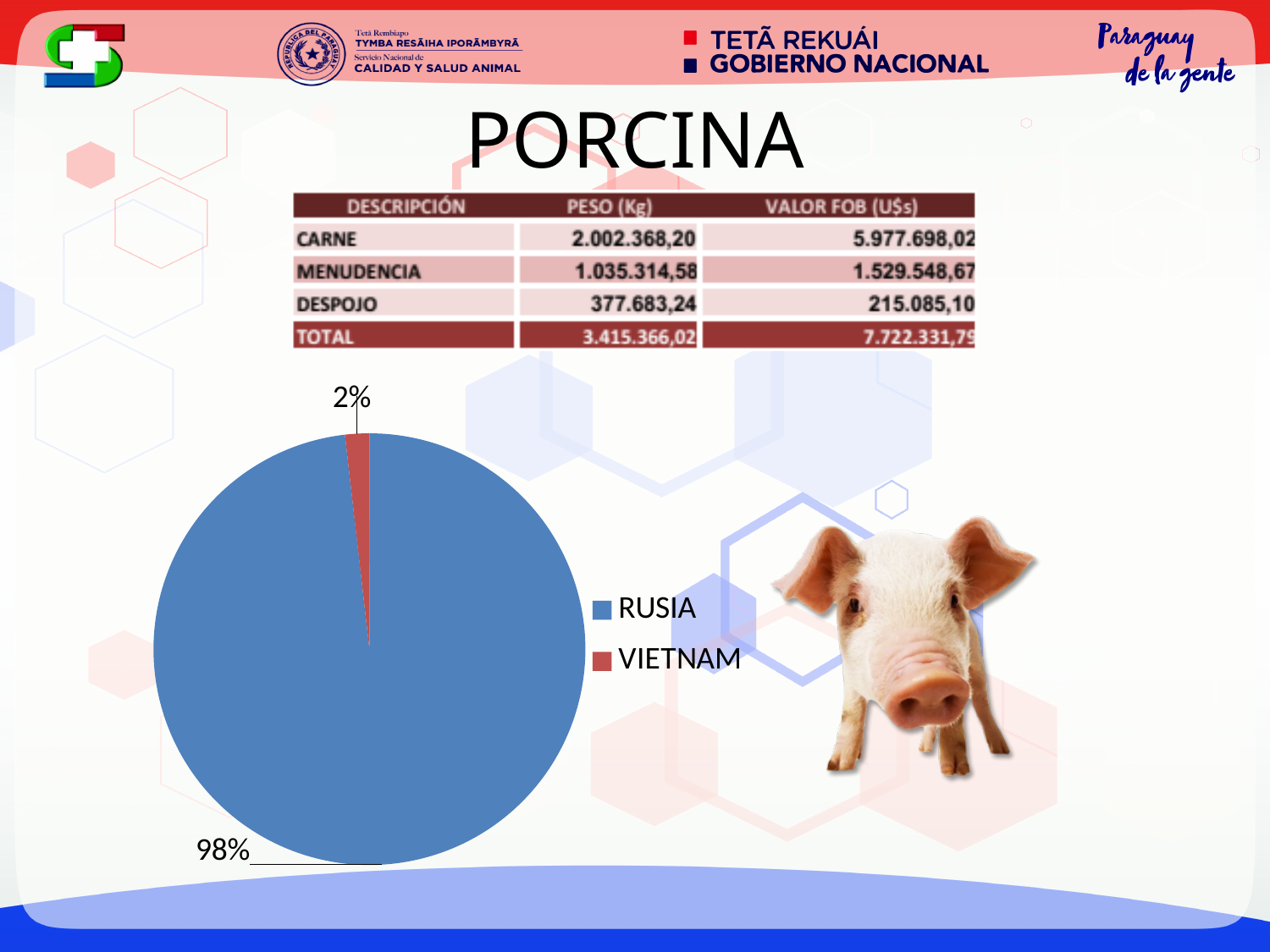
What colour is the RUSIA slice in the pie chart? blue What share of the pie does VIETNAM account for? 2% What is the difference in percentage points between the RUSIA share and the VIETNAM share? 96 percentage points What share of the pie does RUSIA account for? 98% Which category has the largest slice of the pie? RUSIA How many entries does the legend list? 2 Which category has the smallest slice of the pie? VIETNAM What colour is the VIETNAM slice in the pie chart? red How many categories does the pie chart show? 2 What kind of chart is shown on the slide? pie chart Which is larger, the share for RUSIA or the share for VIETNAM? RUSIA